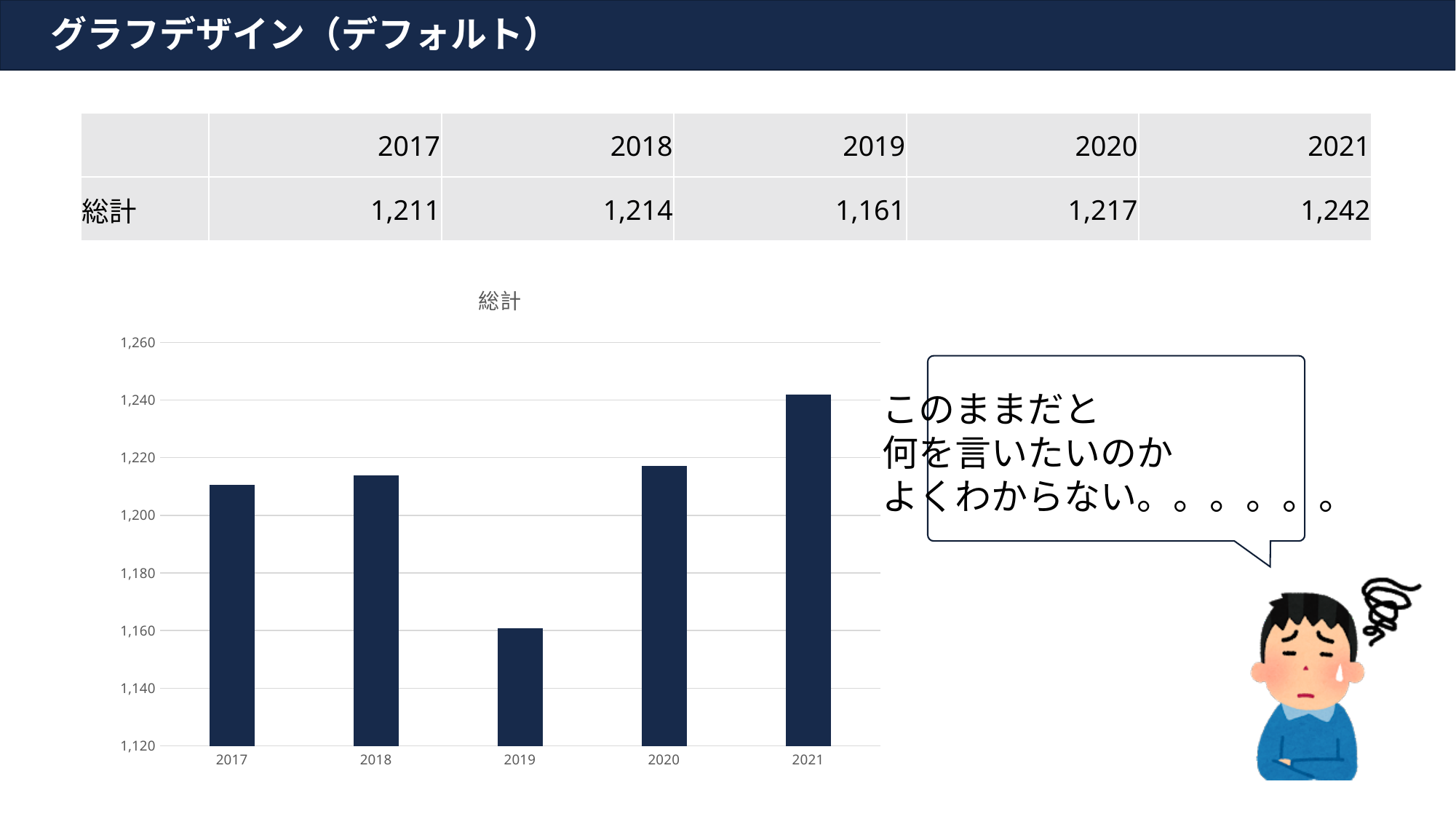
What kind of chart is shown on the slide? bar chart What is the title of the chart? 総計 Which is larger, the value for 2020 or the value for 2019? 2020 What is the 総計 value for 2021? 1,242 How many years (categories) are plotted in the chart? 5 Do the values rise or fall from 2019 to 2021? rise Which year has the highest value in the chart? 2021 What is the difference between the 2021 value and the 2019 value? 81 What is the 総計 value for 2017? 1,211 What is the 総計 value for 2019? 1,161 Which year has the lowest value in the chart? 2019 Is the value for 2019 greater or less than 1,180? less